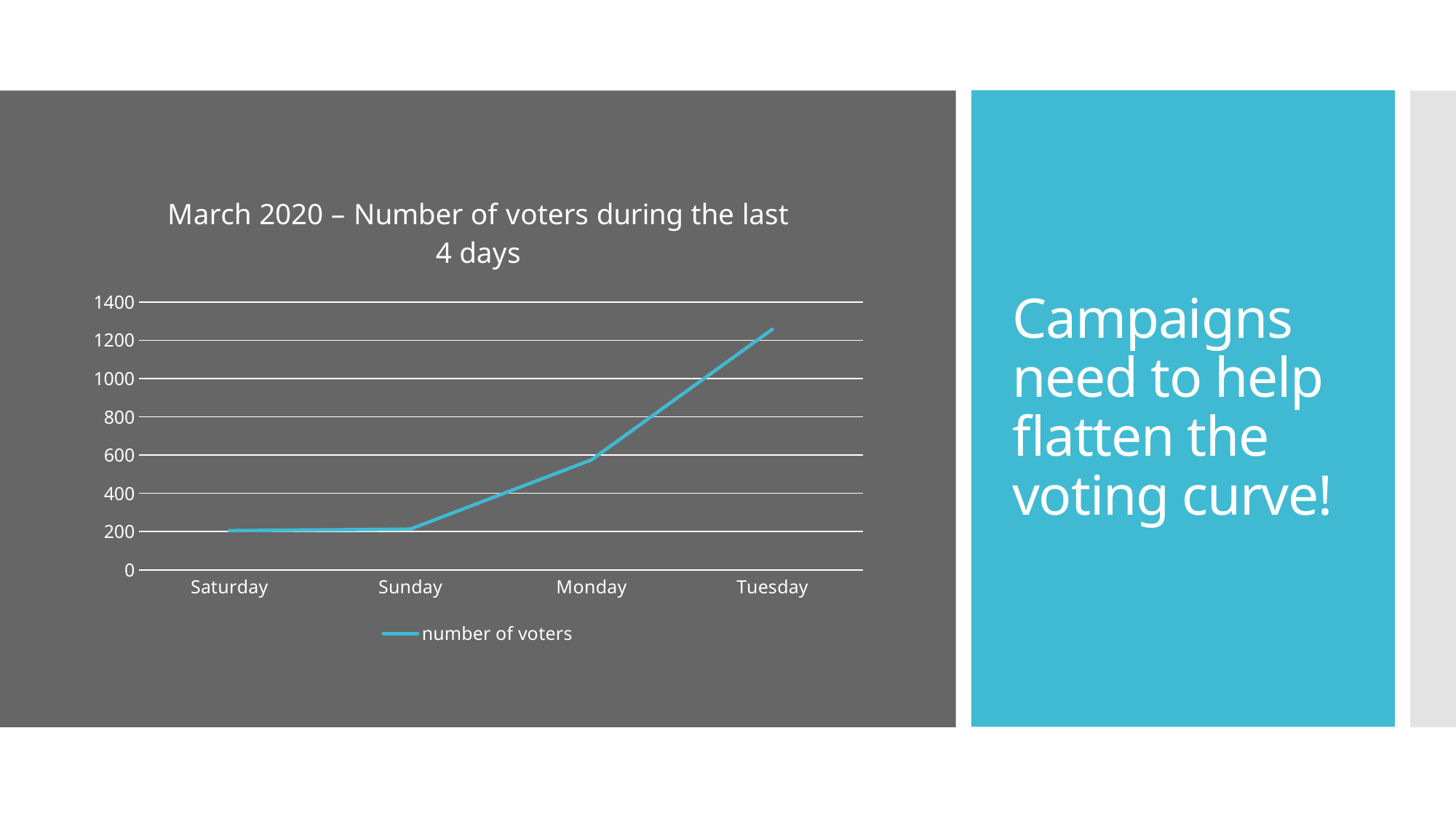
Do the number of voters rise or fall from Saturday to Tuesday? rise Is the number of voters on Saturday greater or less than 400? less Is the number of voters on Monday greater or less than 800? less Which day has the highest number of voters? Tuesday Is the number of voters on Monday greater or less than 400? greater How many days are plotted along the x axis? 4 What is the title of the chart? March 2020 – Number of voters during the last 4 days How many series does the legend list? 1 Which day has more voters, Monday or Tuesday? Tuesday What is the name of the series shown in the legend? number of voters What kind of chart is shown on the slide? line chart